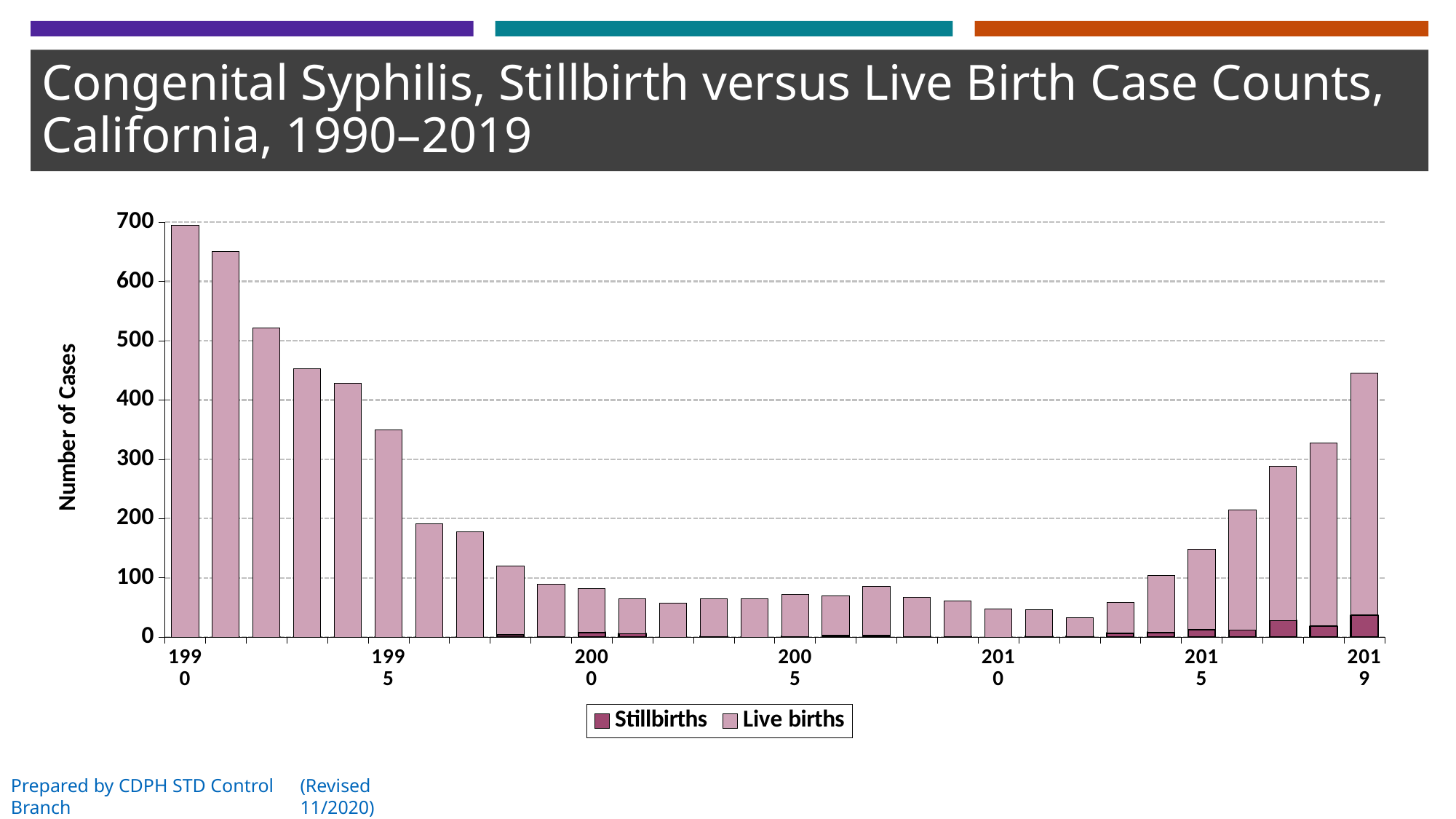
Do the total case counts rise or fall from 1990 to 2000? Fall What are the two series named in the legend? Stillbirths and Live births How many series does the legend list? 2 Is the total number of cases in 2019 greater or less than 400? greater Is the total number of cases in 2000 greater or less than 100? less What kind of chart is shown on the slide? Stacked bar chart Is the total number of cases in 1990 greater or less than 600? greater How many years (bars) are plotted on the chart? 30 Which year has the highest total number of cases? 1990 Which year has a higher total number of cases, 1990 or 2019? 1990 What is the label of the vertical axis? Number of Cases